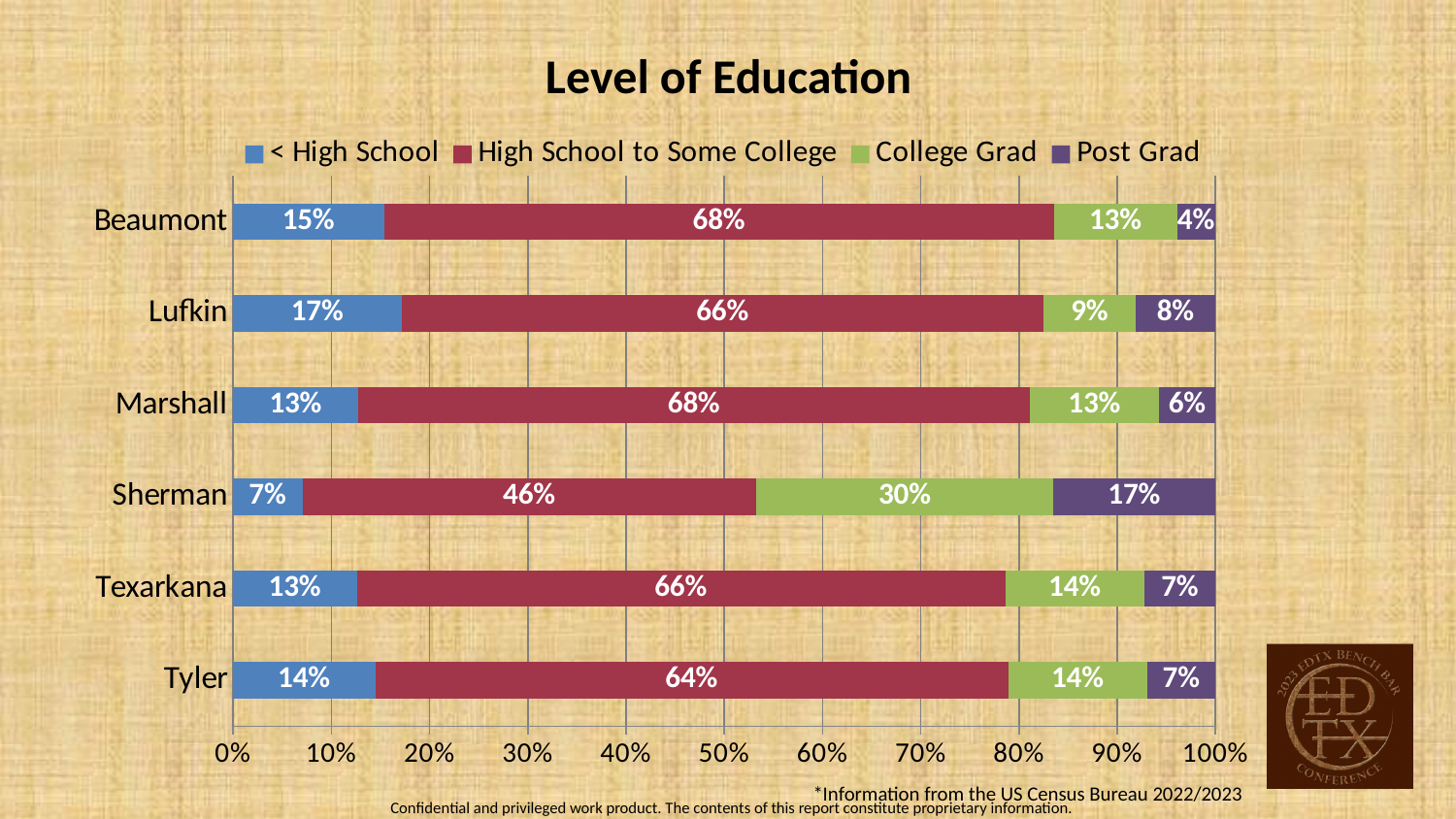
Which series is shown in green in the legend? College Grad Which city has the lowest < High School percentage? Sherman Which is larger: the College Grad percentage for Lufkin or for Texarkana? Texarkana What is the Post Grad percentage for Lufkin? 8% What is the difference between the < High School percentages for Lufkin and Marshall? 4% What kind of chart is shown on the slide? Stacked bar chart How many series does the legend list? 4 What is the title of the chart? Level of Education How many cities are shown on the chart? 6 What is the High School to Some College percentage for Tyler? 64% What is the College Grad percentage for Sherman? 30% Which city has the highest Post Grad percentage? Sherman